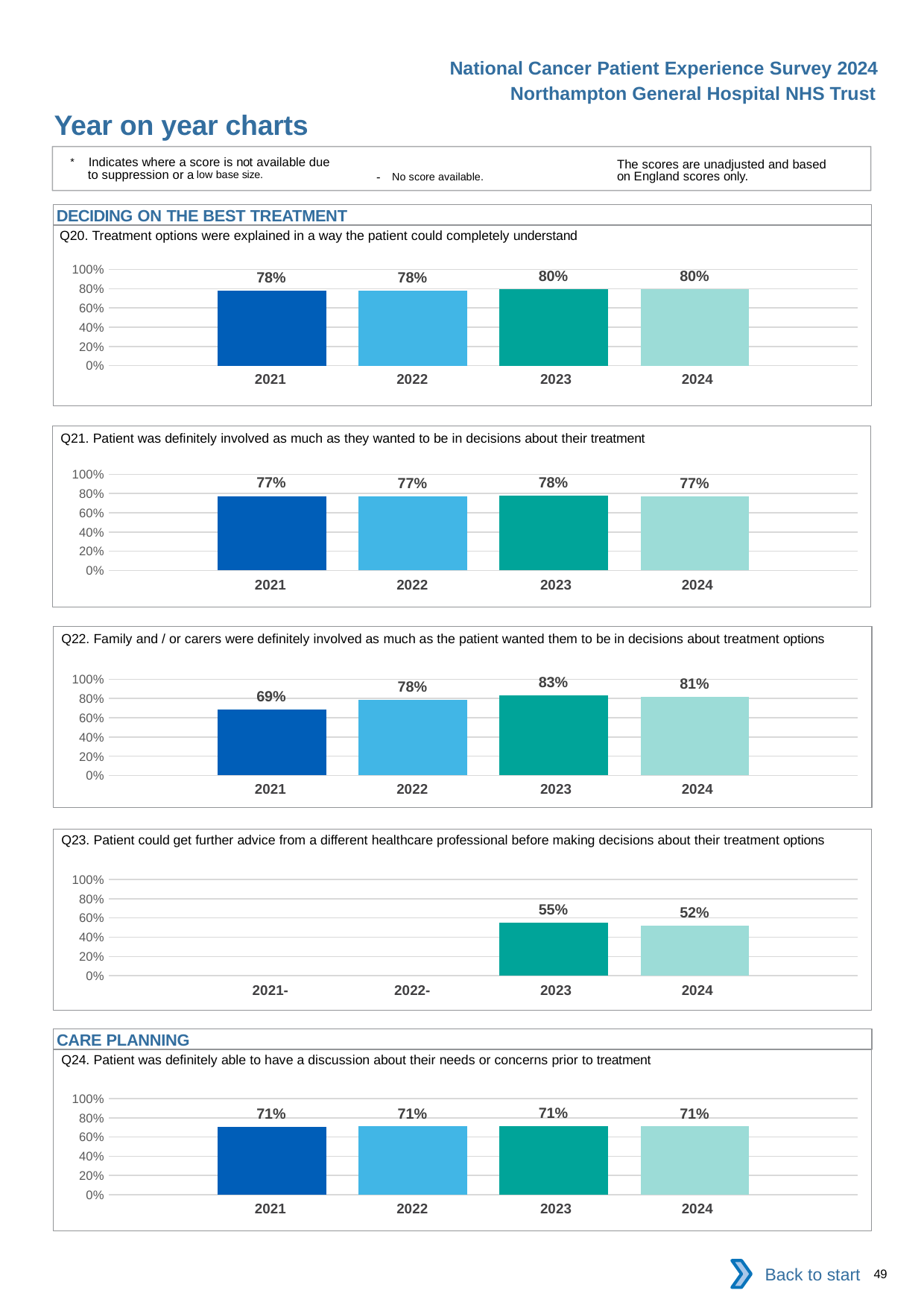
In the Q22 chart, which year has the lowest value? 2021 In the Q24 chart, what is the value for 2022? 71% In the Q20 chart, what is the value for 2023? 80% What kind of chart is used for Q20? bar chart In the Q24 chart, do the values rise, fall or stay the same from 2021 to 2024? stay the same In the Q23 chart, what is the value for 2024? 52% In the Q23 chart, is the value for 2023 larger or smaller than the value for 2024? larger In the Q21 chart, which year has the highest value? 2023 In the Q23 chart, how many years have a bar plotted? 2 In the Q22 chart, what is the difference between the 2022 and 2024 values? 3 percentage points Which section heading appears above the Q24 chart? CARE PLANNING In the Q22 chart, what is the difference between the 2023 and 2021 values? 14 percentage points